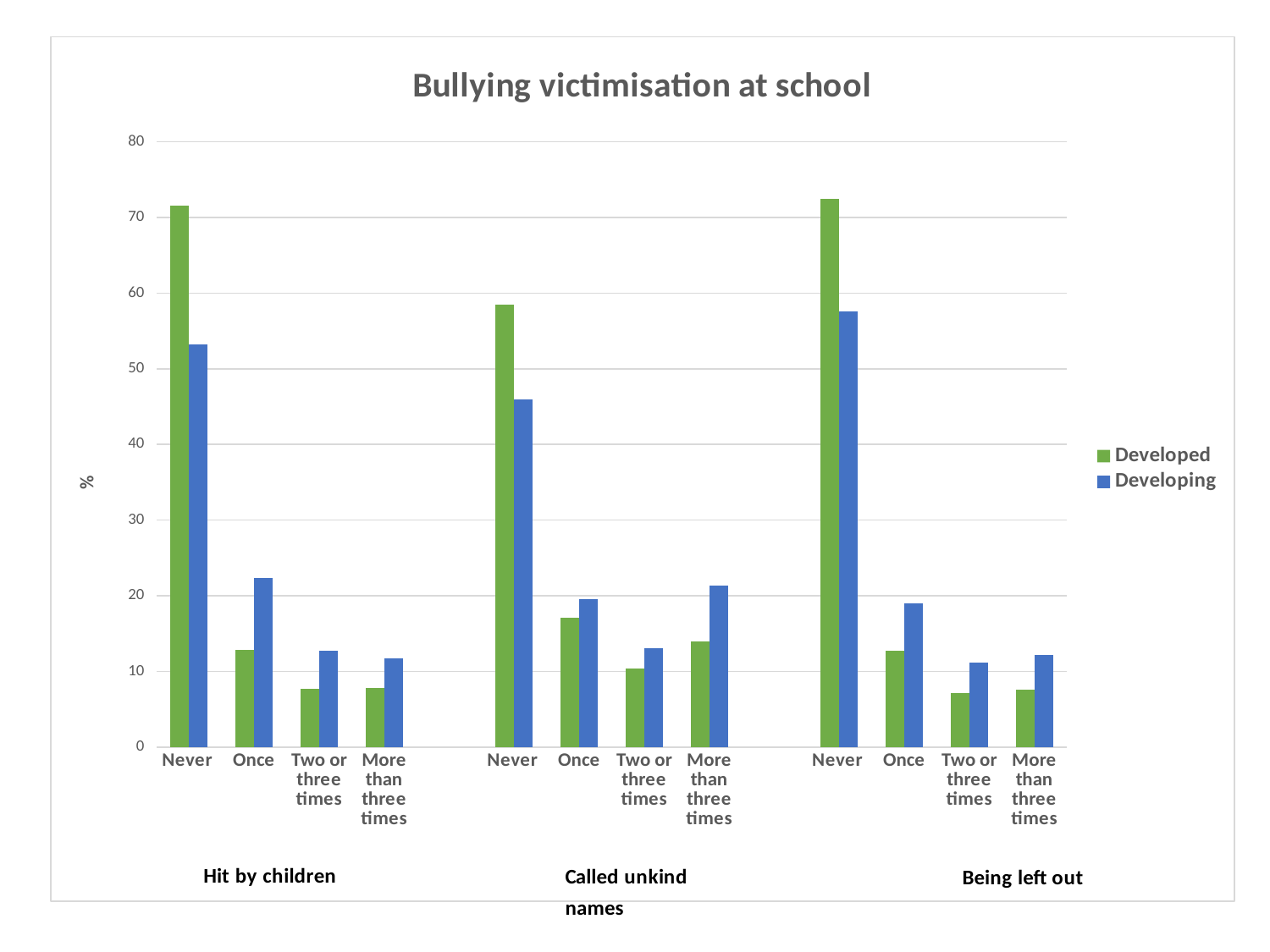
Is the Developed value for Never under Hit by children greater or less than 60? greater Is the Developed value for Never under Called unkind names greater or less than 50? greater For Once under Hit by children, which series has the larger value, Developed or Developing? Developing For More than three times under Called unkind names, which series has the larger value, Developed or Developing? Developing Is the Developing value for Once under Hit by children greater or less than 20? greater Within the Called unkind names group, which category has the lowest Developed value? Two or three times How many series does the legend list? 2 What is the title of the chart? Bullying victimisation at school What kind of chart is shown on the slide? Bar chart What are the two series named in the legend? Developed and Developing How many categories are plotted along the x axis in total across the three groups? 12